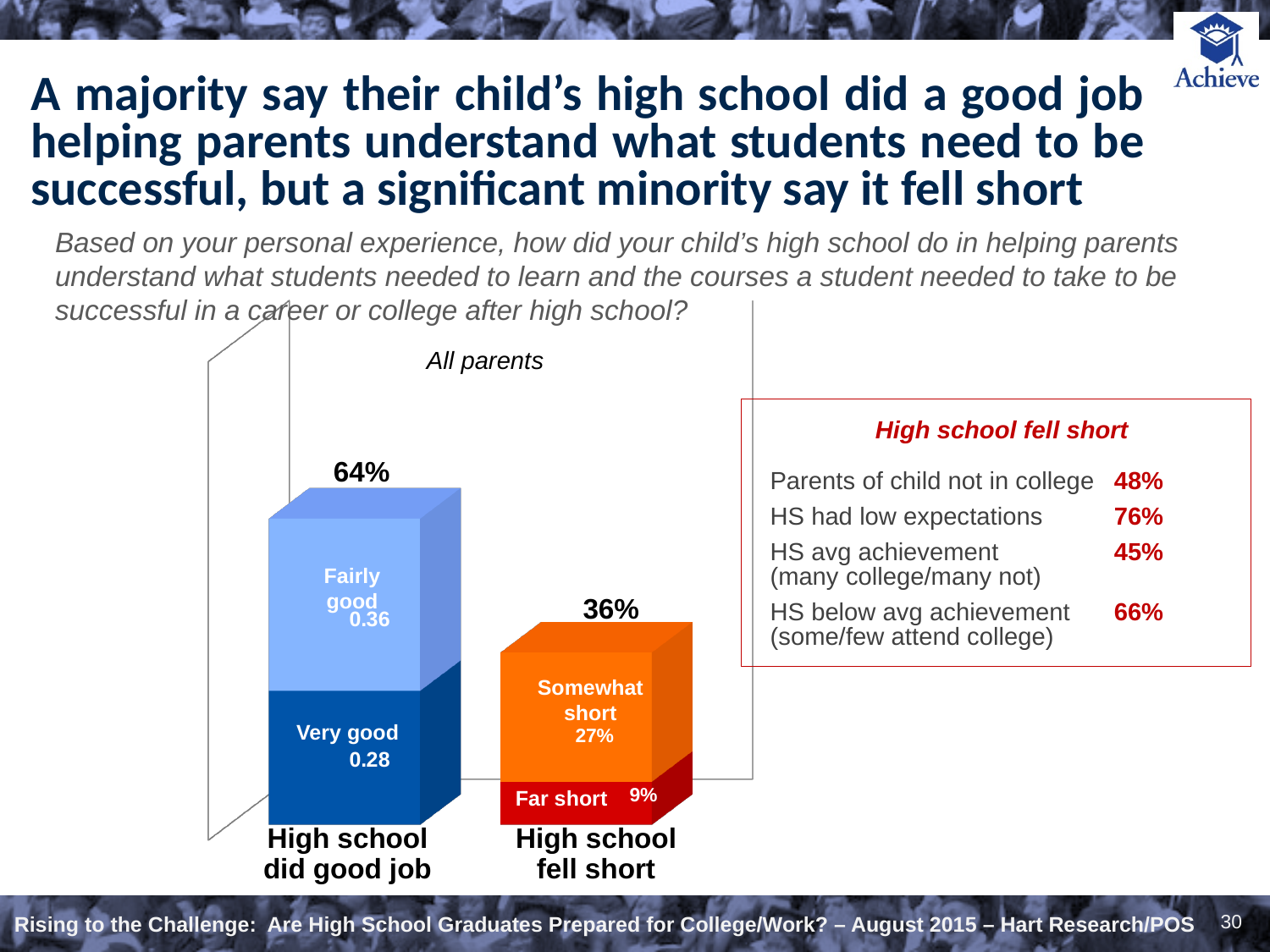
Which segment is larger, 'Somewhat short' or 'Far short'? Somewhat short What value is shown for the 'Very good' segment of the 'High school did good job' bar? 0.28 What value is shown for the 'Fairly good' segment of the 'High school did good job' bar? 0.36 Which bar is taller, 'High school did good job' or 'High school fell short'? High school did good job What is the difference between the 'Somewhat short' (27%) and 'Far short' (9%) segments? 18 percentage points What kind of chart is shown on the slide? Stacked bar chart What percentage of all parents say their child's high school did a good job? 64% What percentage is shown for the 'Far short' segment of the 'High school fell short' bar? 9% How many bars are plotted in the chart? 2 What percentage of all parents say their child's high school fell short? 36% What percentage is shown for the 'Somewhat short' segment of the 'High school fell short' bar? 27% What is the difference between the 'High school did good job' total (64%) and the 'High school fell short' total (36%)? 28 percentage points